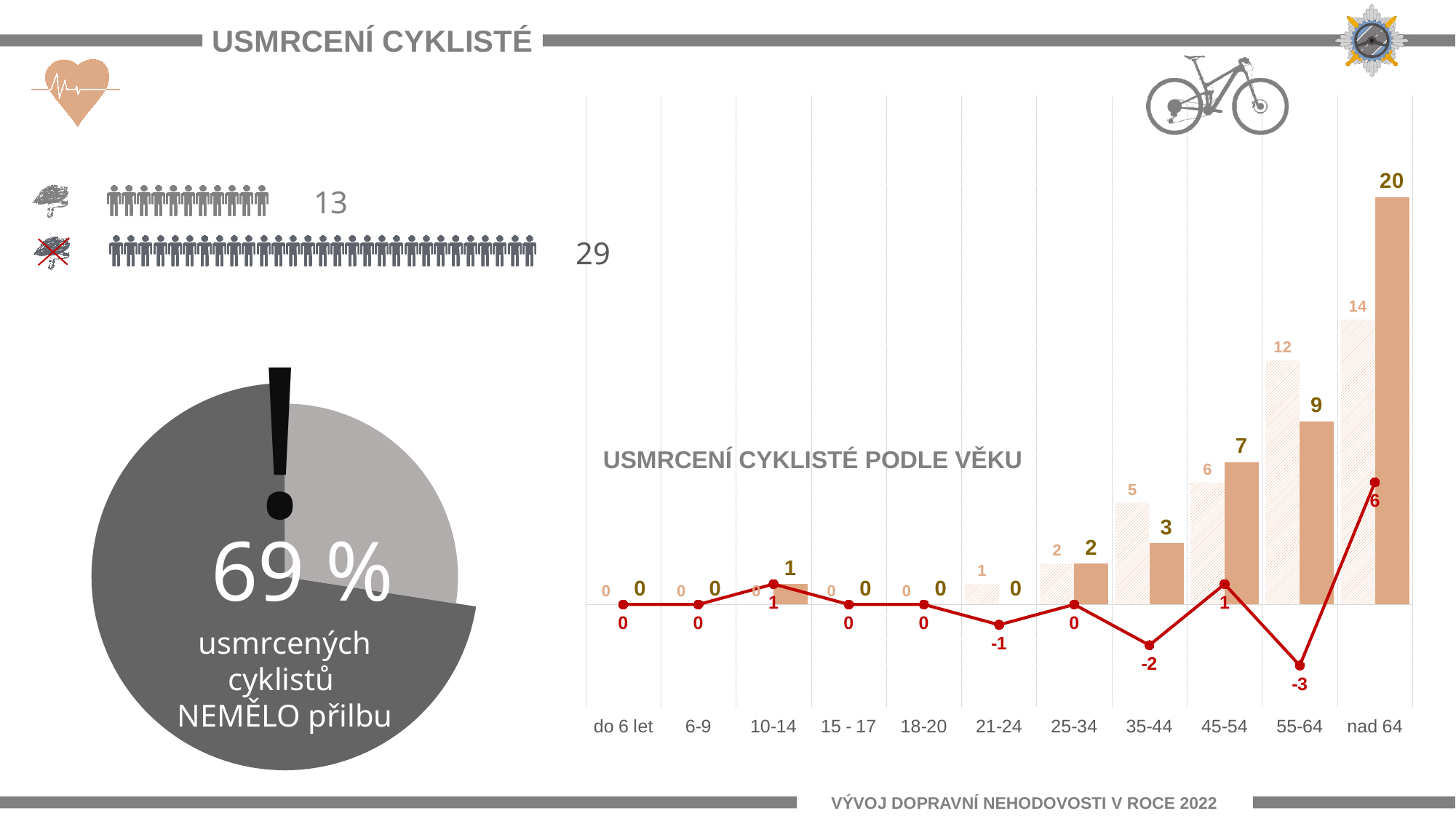
What is the title of the bar chart on the right of the slide? USMRCENÍ CYKLISTÉ PODLE VĚKU What kind of chart is 'USMRCENÍ CYKLISTÉ PODLE VĚKU'? bar chart with a line What share of the pie chart on the left does the dark slice represent? 69 % In the chart 'USMRCENÍ CYKLISTÉ PODLE VĚKU', how many age groups are shown on the x axis? 11 In the chart 'USMRCENÍ CYKLISTÉ PODLE VĚKU', which age group has the lowest value on the red line? 55-64 In the chart 'USMRCENÍ CYKLISTÉ PODLE VĚKU', what value does the red line show for the '55-64' age group? -3 In the chart 'USMRCENÍ CYKLISTÉ PODLE VĚKU', do the solid bar values generally rise or fall from the youngest to the oldest age group? rise In the chart 'USMRCENÍ CYKLISTÉ PODLE VĚKU', what is the value of the solid bar for the 'nad 64' age group? 20 In the chart 'USMRCENÍ CYKLISTÉ PODLE VĚKU', which age group has the highest solid bar? nad 64 In the chart 'USMRCENÍ CYKLISTÉ PODLE VĚKU', what is the value of the hatched bar for the '55-64' age group? 12 In the chart 'USMRCENÍ CYKLISTÉ PODLE VĚKU', is the solid bar for '45-54' larger or smaller than the hatched bar for '45-54'? larger In the chart 'USMRCENÍ CYKLISTÉ PODLE VĚKU', what is the difference between the solid bar and the hatched bar for the 'nad 64' age group? 6